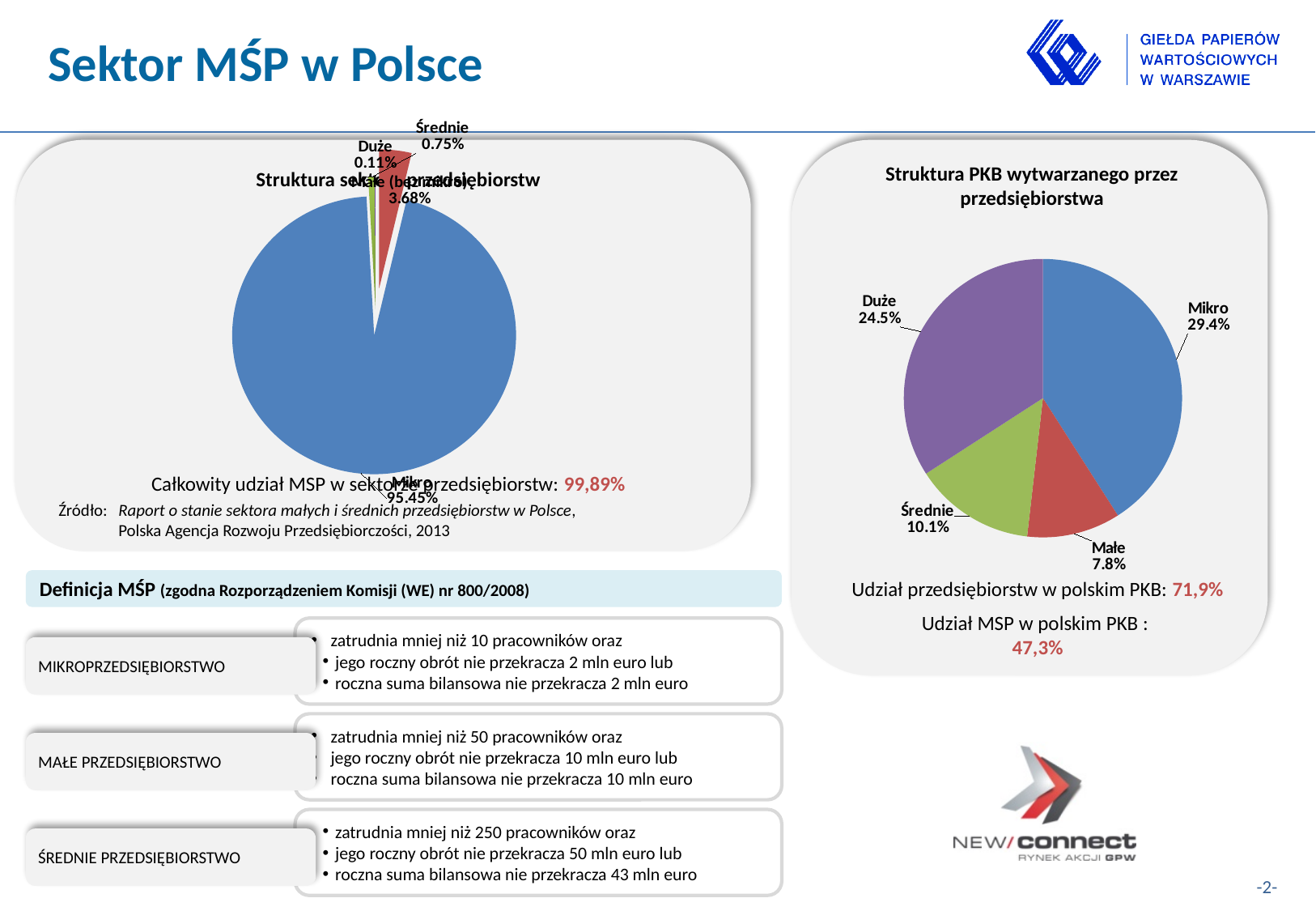
In the right chart 'Struktura PKB wytwarzanego przez przedsiębiorstwa', which category has the largest share? Mikro In the left pie chart on the slide, what is the share for Małe? 3.68% In the right chart 'Struktura PKB wytwarzanego przez przedsiębiorstwa', what is the share for Mikro? 29.4% In the right chart 'Struktura PKB wytwarzanego przez przedsiębiorstwa', which category has the smallest share? Małe In the left pie chart on the slide, what is the share for Mikro? 95.45% In the right chart 'Struktura PKB wytwarzanego przez przedsiębiorstwa', what is the difference in percentage points between Mikro and Duże? 4.9 In the right chart 'Struktura PKB wytwarzanego przez przedsiębiorstwa', which is larger: Średnie or Małe? Średnie How many categories does the right chart 'Struktura PKB wytwarzanego przez przedsiębiorstwa' show? 4 In the right chart 'Struktura PKB wytwarzanego przez przedsiębiorstwa', what is the share for Średnie? 10.1% In the left pie chart on the slide, what is the share for Duże? 0.11% What type of chart is the right chart 'Struktura PKB wytwarzanego przez przedsiębiorstwa'? Pie chart In the right chart 'Struktura PKB wytwarzanego przez przedsiębiorstwa', what is the share for Duże? 24.5%